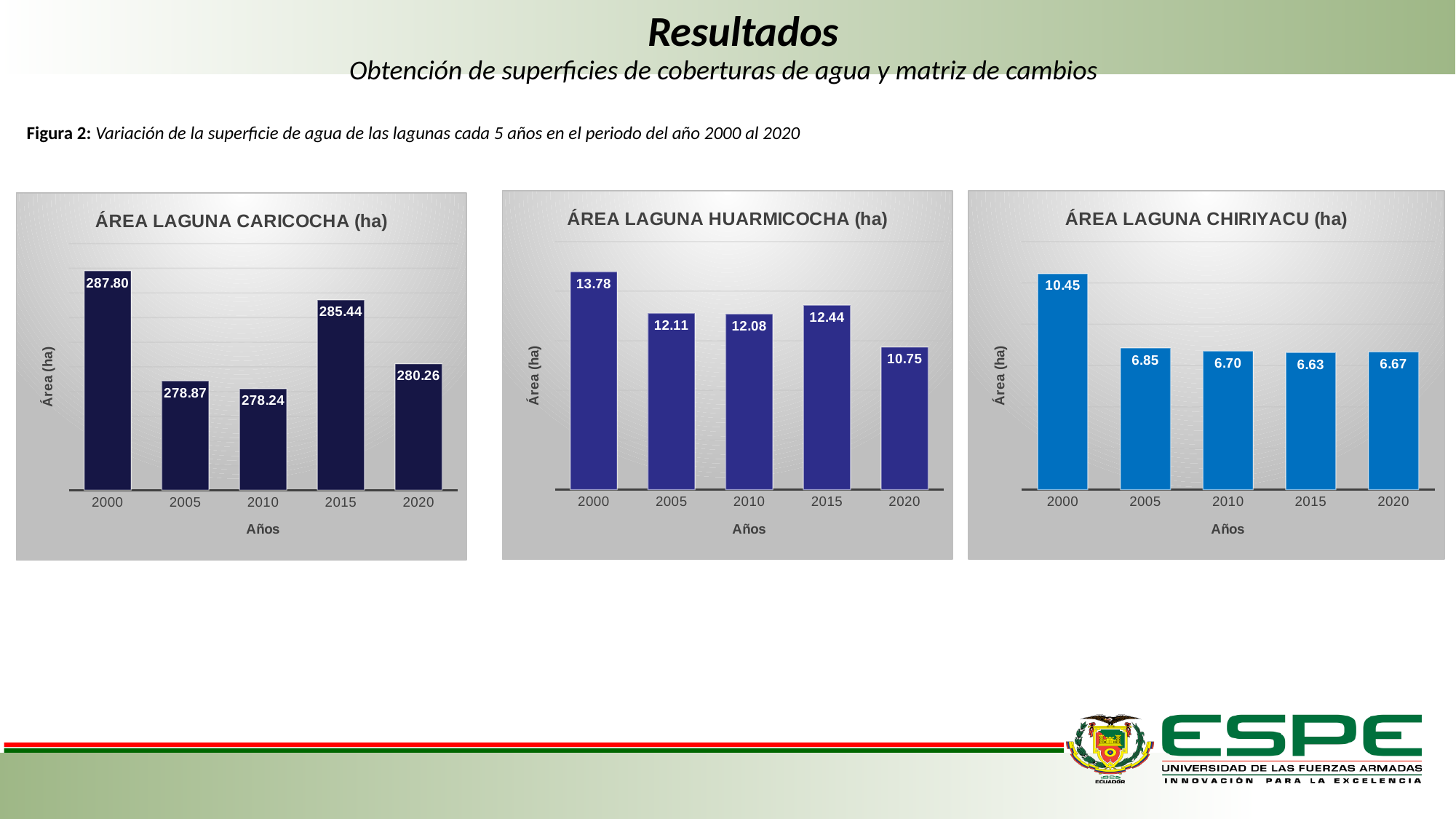
In the chart titled ÁREA LAGUNA CHIRIYACU (ha), what is the difference between the values for 2000 and 2020? 3.78 In the chart titled ÁREA LAGUNA HUARMICOCHA (ha), what is the value for 2020? 10.75 How many years are shown on the x axis of the chart titled ÁREA LAGUNA CARICOCHA (ha)? 5 What is the x-axis label of the chart titled ÁREA LAGUNA CHIRIYACU (ha)? Años In the chart titled ÁREA LAGUNA HUARMICOCHA (ha), which year has the highest value? 2000 In the chart titled ÁREA LAGUNA CARICOCHA (ha), what is the difference between the values for 2000 and 2015? 2.36 In the chart titled ÁREA LAGUNA CARICOCHA (ha), what is the value for 2000? 287.80 In the chart titled ÁREA LAGUNA CHIRIYACU (ha), which year has the lowest value? 2015 In the chart titled ÁREA LAGUNA HUARMICOCHA (ha), which is larger, the value for 2005 or the value for 2015? 2015 In the chart titled ÁREA LAGUNA CARICOCHA (ha), which year has the lowest value? 2010 In the chart titled ÁREA LAGUNA CHIRIYACU (ha), what is the value for 2015? 6.63 What kind of chart is the chart titled ÁREA LAGUNA HUARMICOCHA (ha)? Bar chart